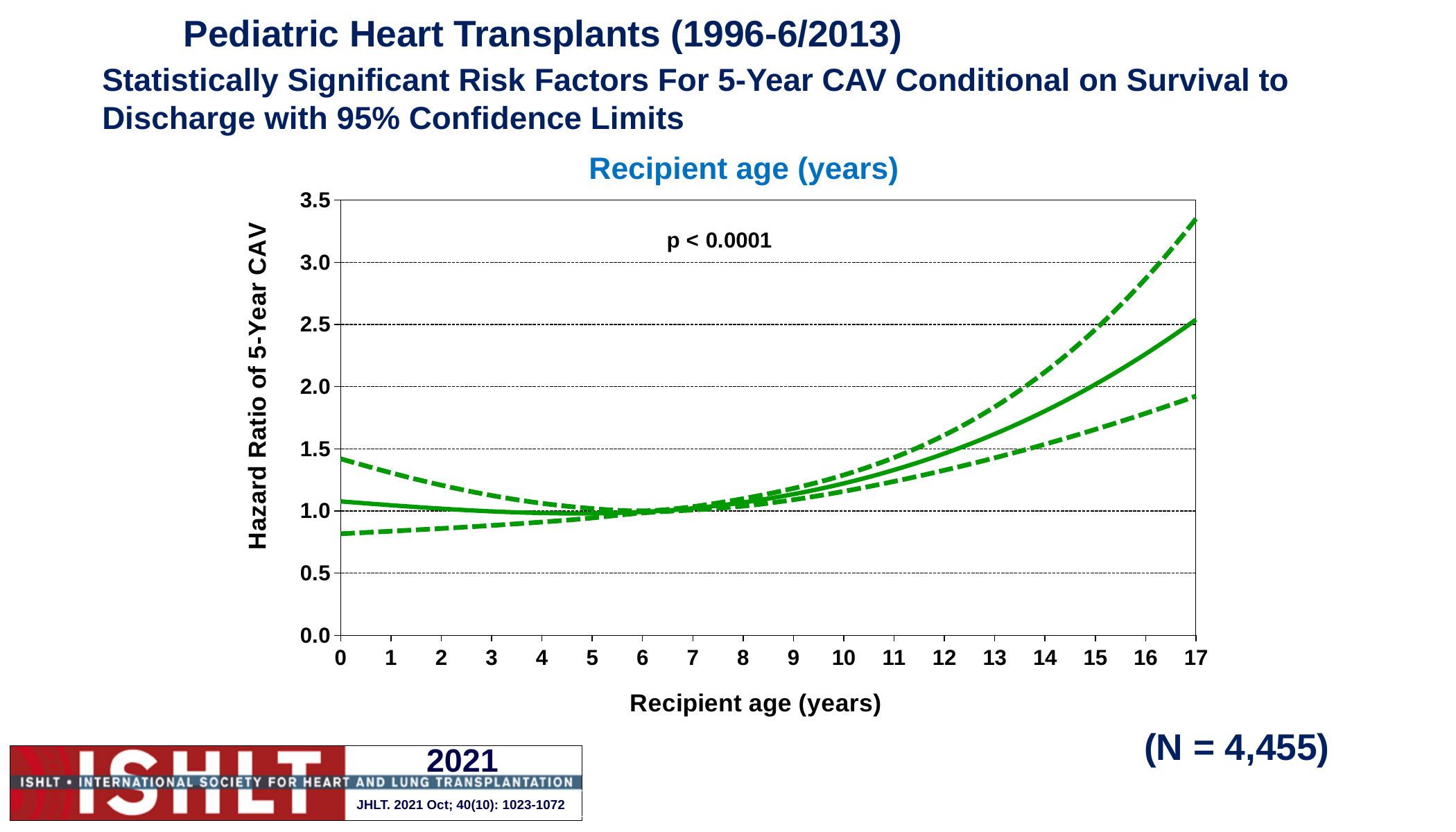
Is the value of the lower dashed confidence limit at recipient age 17 greater or less than 2.0? less What kind of chart is shown on the slide? line chart Is the value of the solid hazard ratio line at recipient age 14 greater or less than 1.5? greater Is the value of the lower dashed confidence limit at recipient age 0 greater or less than 1.0? less Does the solid hazard ratio line rise or fall between recipient age 10 and 17? rise What is the label of the y axis? Hazard Ratio of 5-Year CAV What is the p-value printed on the chart? p < 0.0001 How many lines are plotted on the chart? 3